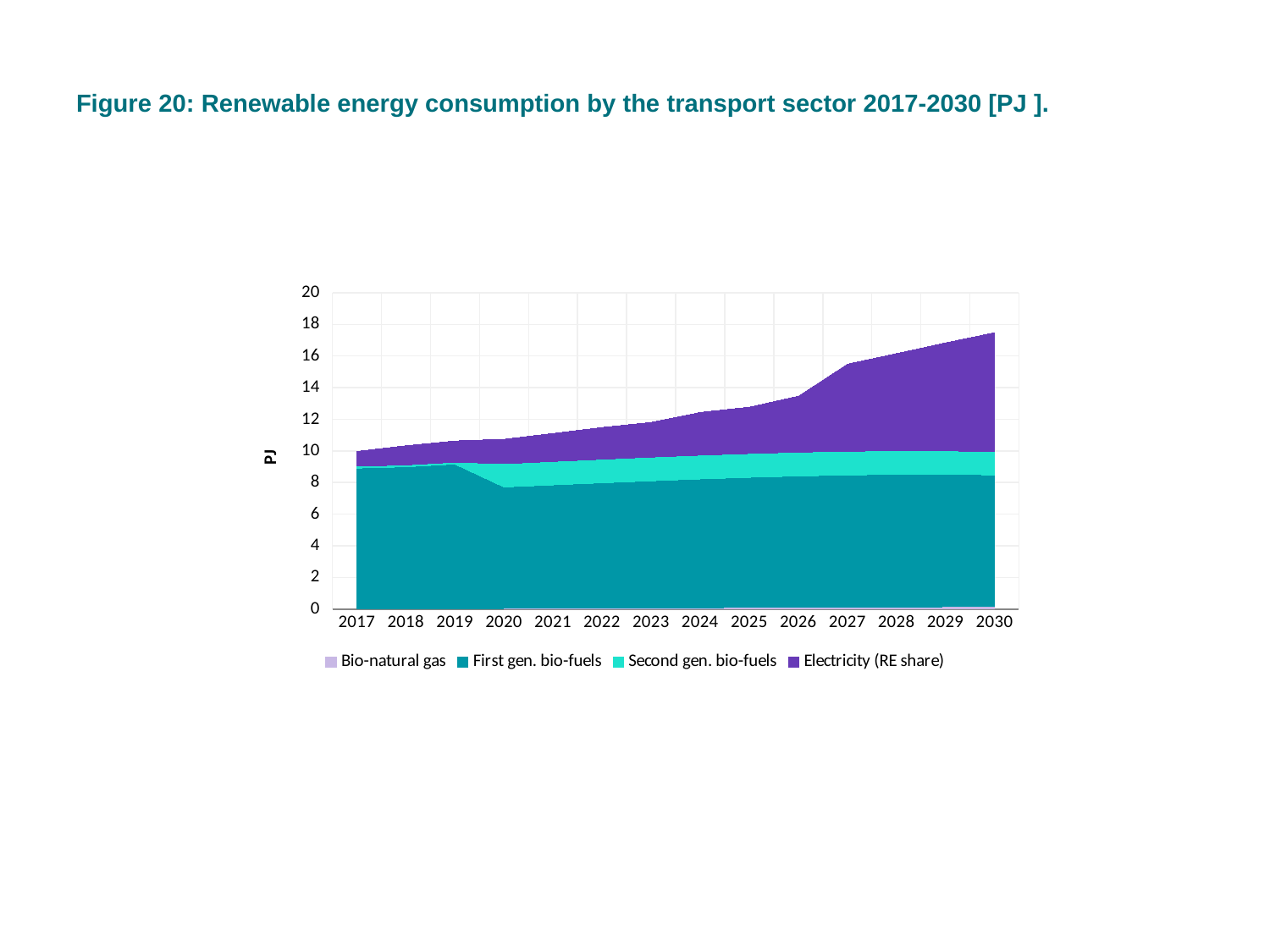
Which year has the larger total renewable energy consumption, 2017 or 2030? 2030 Is the total renewable energy consumption in 2020 greater or less than 12 PJ? less How many series does the legend list? 4 Is the total renewable energy consumption in 2017 greater or less than 12 PJ? less Which year has the highest total renewable energy consumption? 2030 Does total renewable energy consumption rise or fall from 2017 to 2030? Rise Is the value for First gen. bio-fuels in 2017 greater or less than 8 PJ? greater What kind of chart is shown on the slide? Stacked area chart What is the label on the y axis? PJ Which year has the lowest total renewable energy consumption? 2017 How many years are shown along the x axis? 14